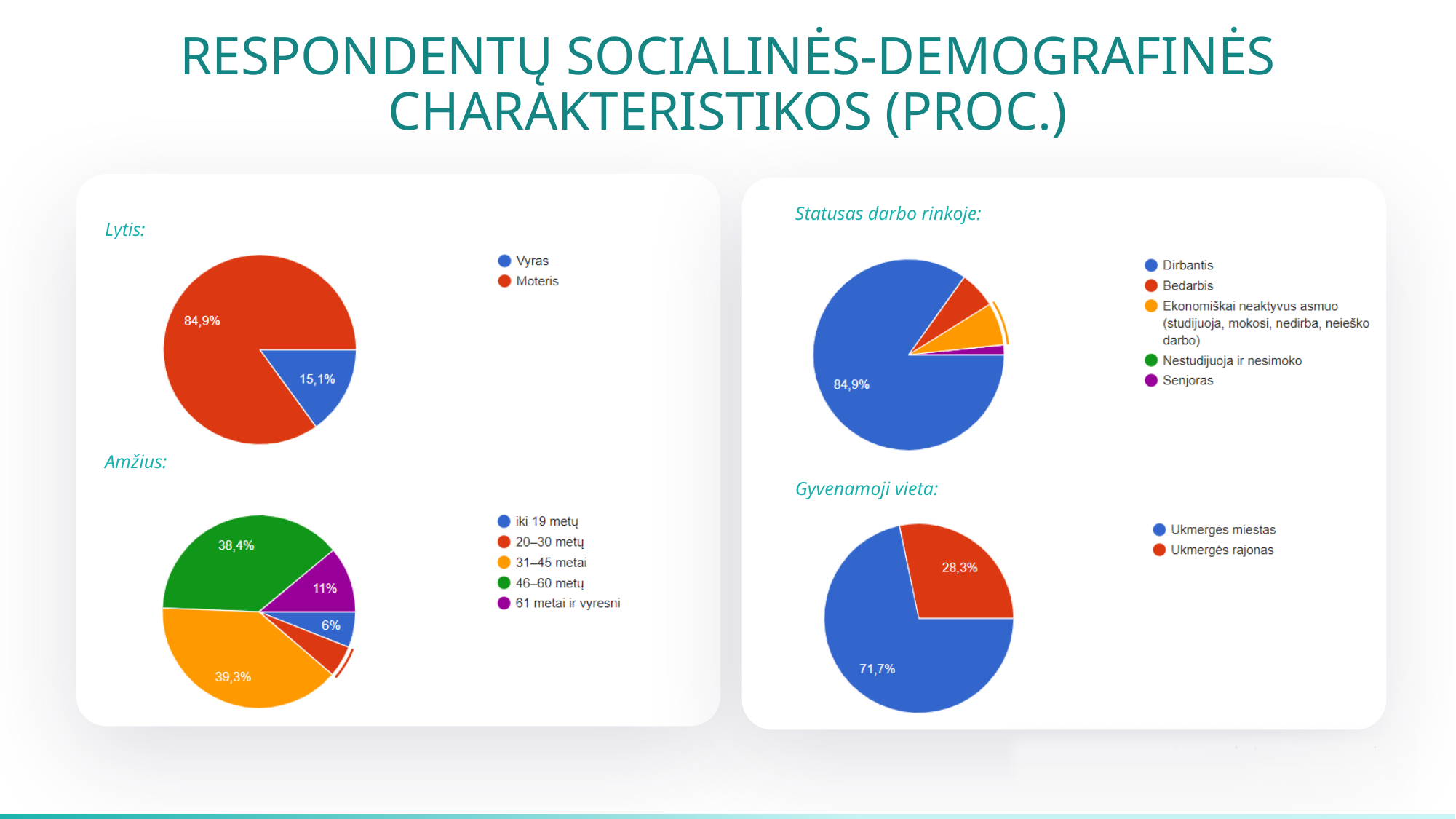
In the "Amžius" chart, how many age categories does the legend list? 5 In the "Gyvenamoji vieta" chart, what share of respondents live in Ukmergės rajonas? 28,3% In the "Amžius" chart, which is larger: the share for 61 metai ir vyresni or the share for iki 19 metų? 61 metai ir vyresni In the "Amžius" chart, what is the share for 46–60 metų? 38,4% In the "Statusas darbo rinkoje" chart, what share of respondents are Dirbantis? 84,9% In the "Amžius" chart, what is the share for 61 metai ir vyresni? 11% In the "Amžius" chart, what is the share for 31–45 metai? 39,3% In the "Lytis" chart, what share of respondents are Vyras? 15,1% What type of chart is used for "Gyvenamoji vieta"? Pie chart In the "Gyvenamoji vieta" chart, what is the difference between the Ukmergės miestas and Ukmergės rajonas shares? 43,4% In the "Statusas darbo rinkoje" chart, which category has the largest slice? Dirbantis In the "Lytis" chart, what share of respondents are Moteris? 84,9%